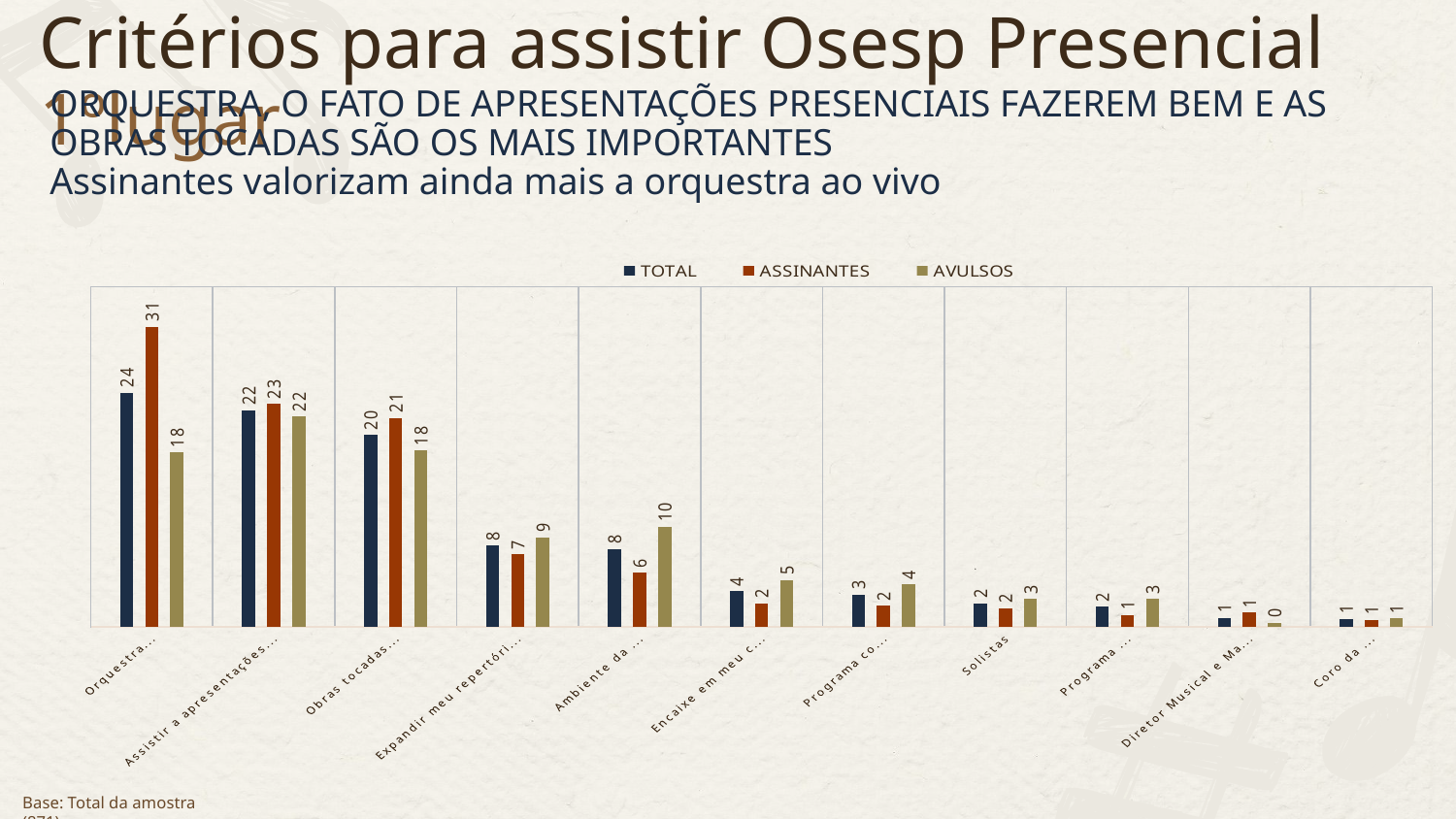
Do the TOTAL values generally rise or fall from left to right along the x axis? fall How many series does the legend list? 3 What is the AVULSOS value for 'Obras tocadas...'? 18 Which category has the highest ASSINANTES value? Orquestra... Which series is shown in red in the legend? ASSINANTES What is the difference between the ASSINANTES and AVULSOS values for 'Orquestra...'? 13 What is the TOTAL value for 'Solistas'? 2 How many categories are shown on the x axis? 11 What is the ASSINANTES value for the 'Orquestra...' category? 31 What kind of chart is shown on the slide? bar chart What is the AVULSOS value for the 'Orquestra...' category? 18 For 'Solistas', which is larger: the AVULSOS value or the TOTAL value? AVULSOS